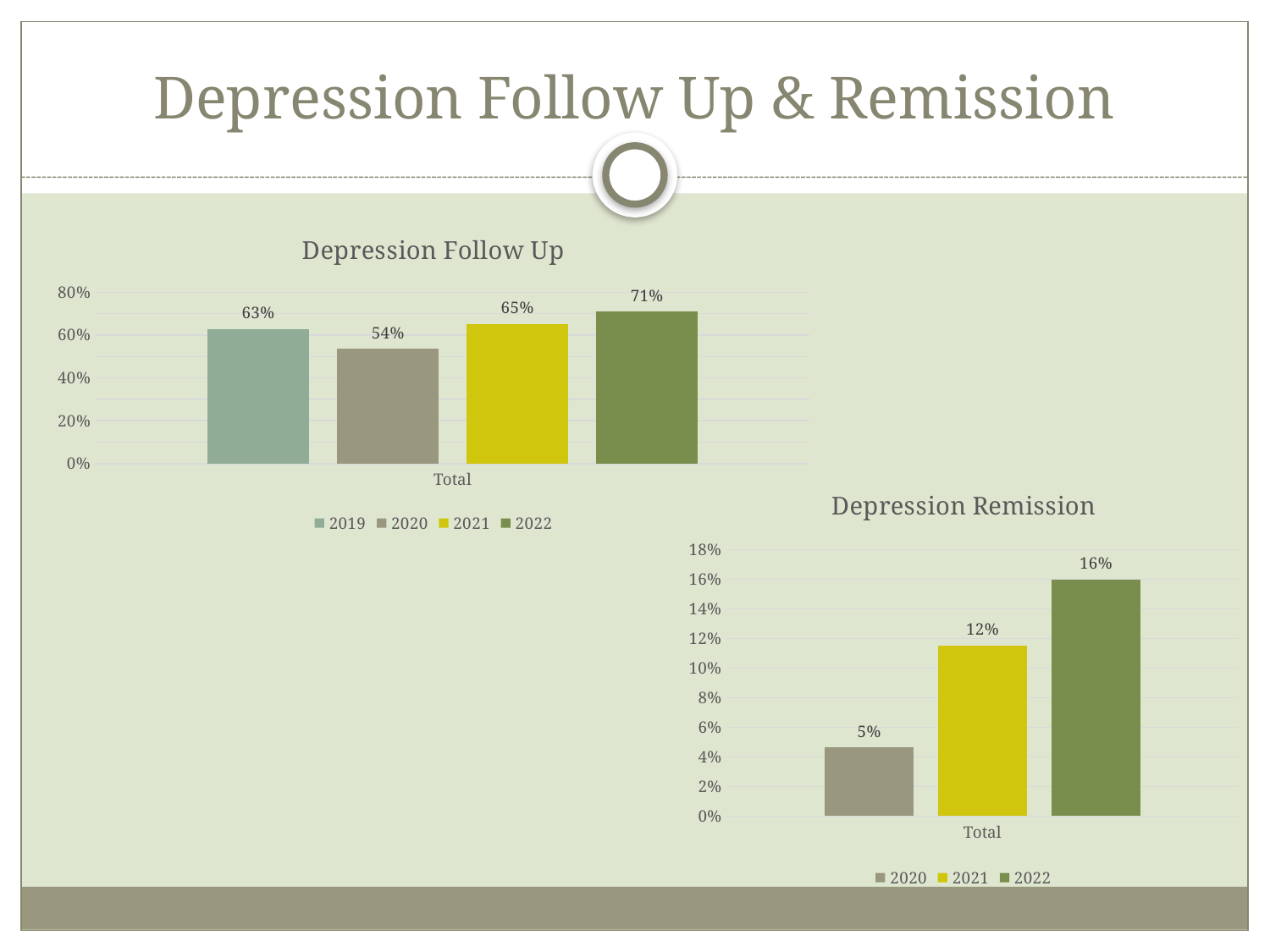
In the Depression Follow Up chart, which year has the lowest value? 2020 What kind of chart is the Depression Remission chart? bar chart In the Depression Follow Up chart, what is the value for 2020? 54% In the Depression Remission chart, what is the difference between the 2022 and 2020 values? 11% In the Depression Follow Up chart, what is the value for 2022? 71% In the Depression Remission chart, which year has the highest value? 2022 In the Depression Remission chart, what is the value for 2020? 5% In the Depression Remission chart, what is the value for 2021? 12% In the Depression Follow Up chart, which year has the highest value? 2022 In the Depression Follow Up chart, what is the difference between the 2022 and 2019 values? 8% In the Depression Remission chart, do the values rise or fall from 2020 to 2022? rise In the Depression Follow Up chart, how many series does the legend list? 4